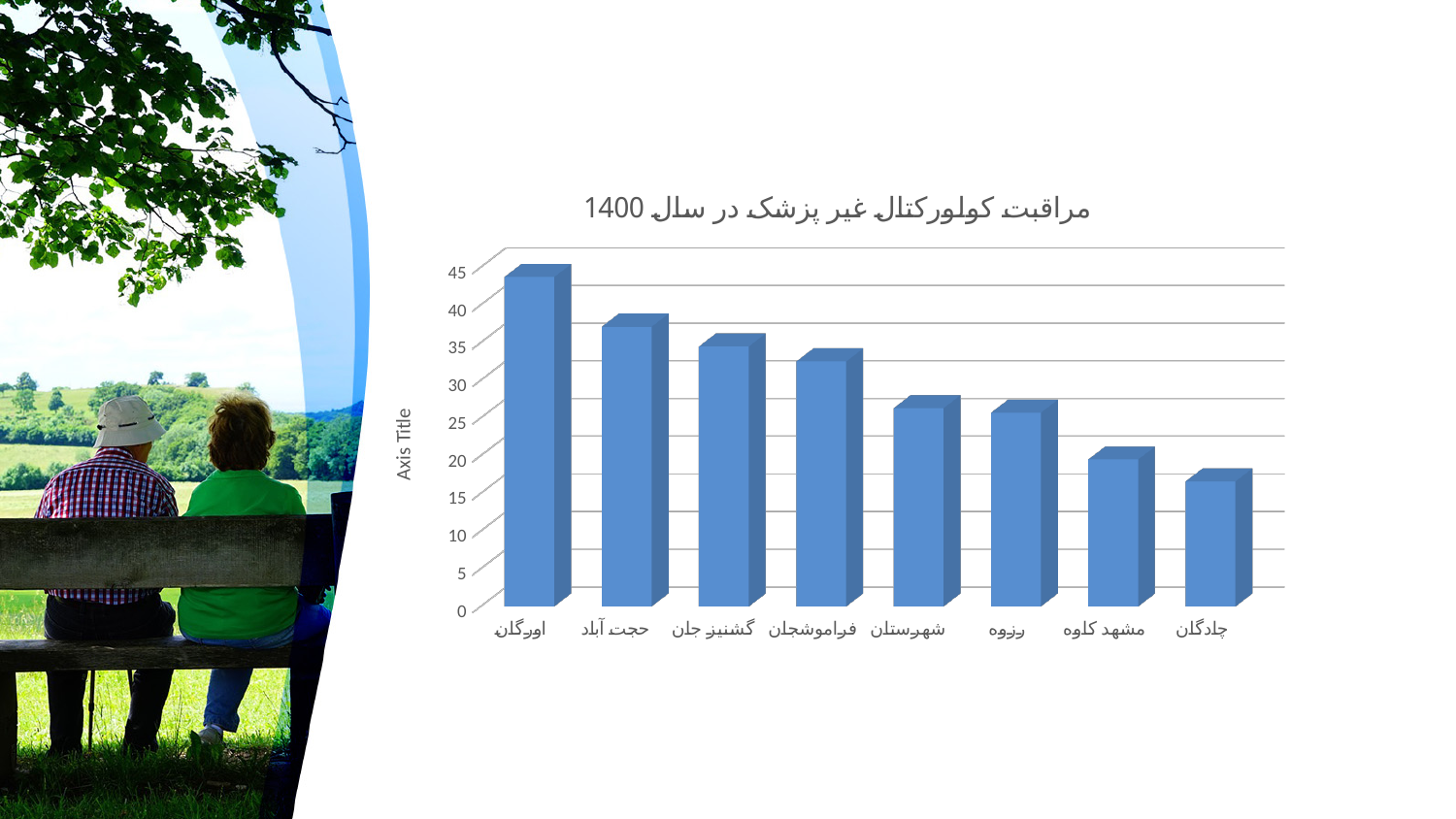
Which category has the lowest value in the chart? چادگان Is the value for چادگان greater or less than 20? less Is the value for اورگان greater or less than 40? greater Which category has the highest value in the chart? اورگان Is the value for حجت آباد greater or less than 40? less How many categories are shown on the x axis of the chart? 8 What is the title of the chart? مراقبت کولورکتال غیر پزشک در سال 1400 What kind of chart is shown on the slide? Bar chart Do the values rise or fall moving from left to right along the x axis? fall What label is shown on the vertical axis of the chart? Axis Title